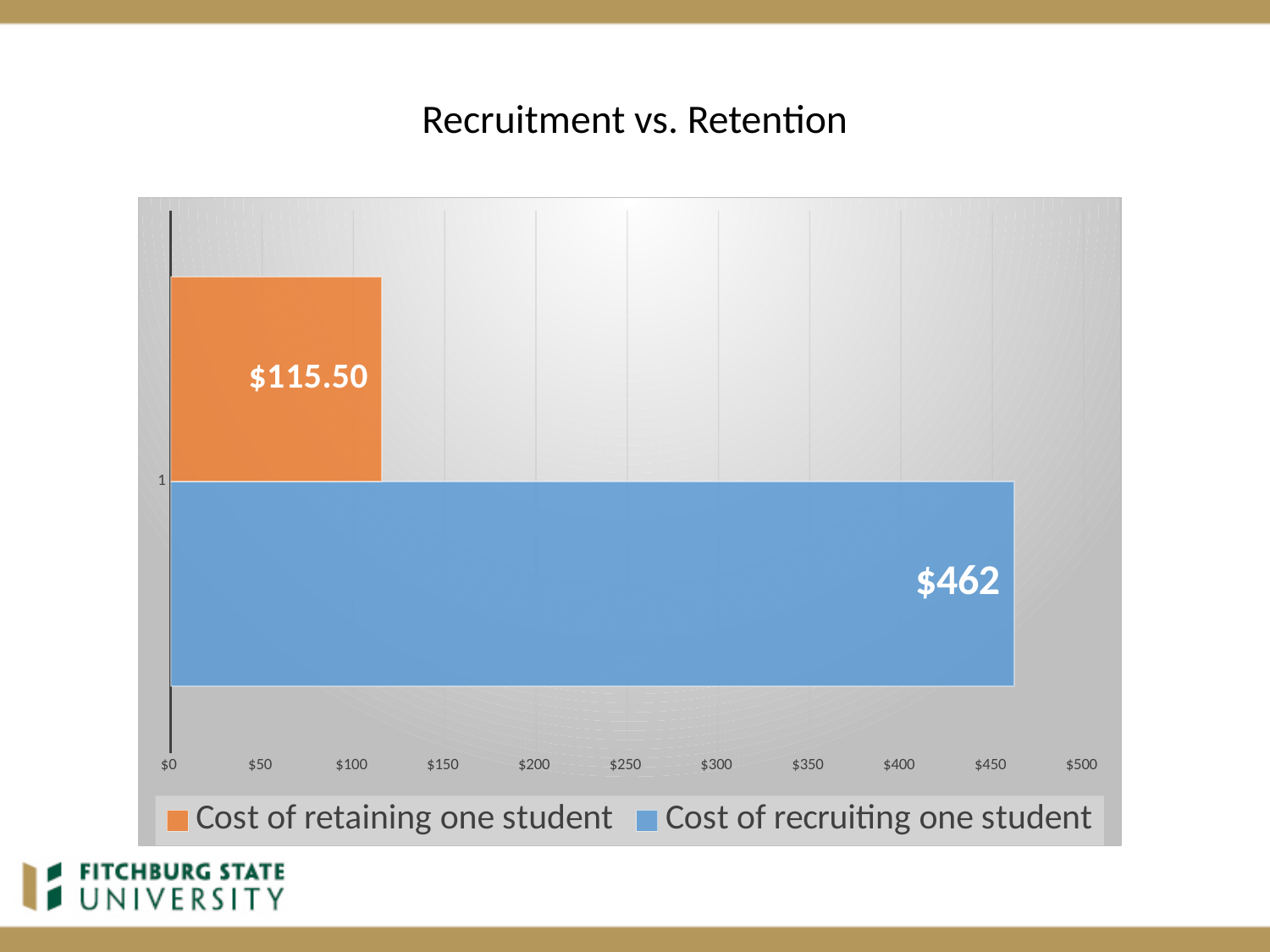
What colour is the bar for the cost of recruiting one student? Blue How many series does the legend list? 2 Is the cost of retaining one student greater or less than $150? less What is the title of the chart? Recruitment vs. Retention What is the maximum value shown on the horizontal axis? $500 What is the cost of retaining one student shown on the chart? $115.50 Which series has the lowest value on the chart? Cost of retaining one student What kind of chart is shown on the slide? Bar chart What is the cost of recruiting one student shown on the chart? $462 Which series has the higher value, cost of retaining one student or cost of recruiting one student? Cost of recruiting one student Is the cost of recruiting one student greater or less than $400? greater What is the difference between the cost of recruiting one student and the cost of retaining one student? $346.50